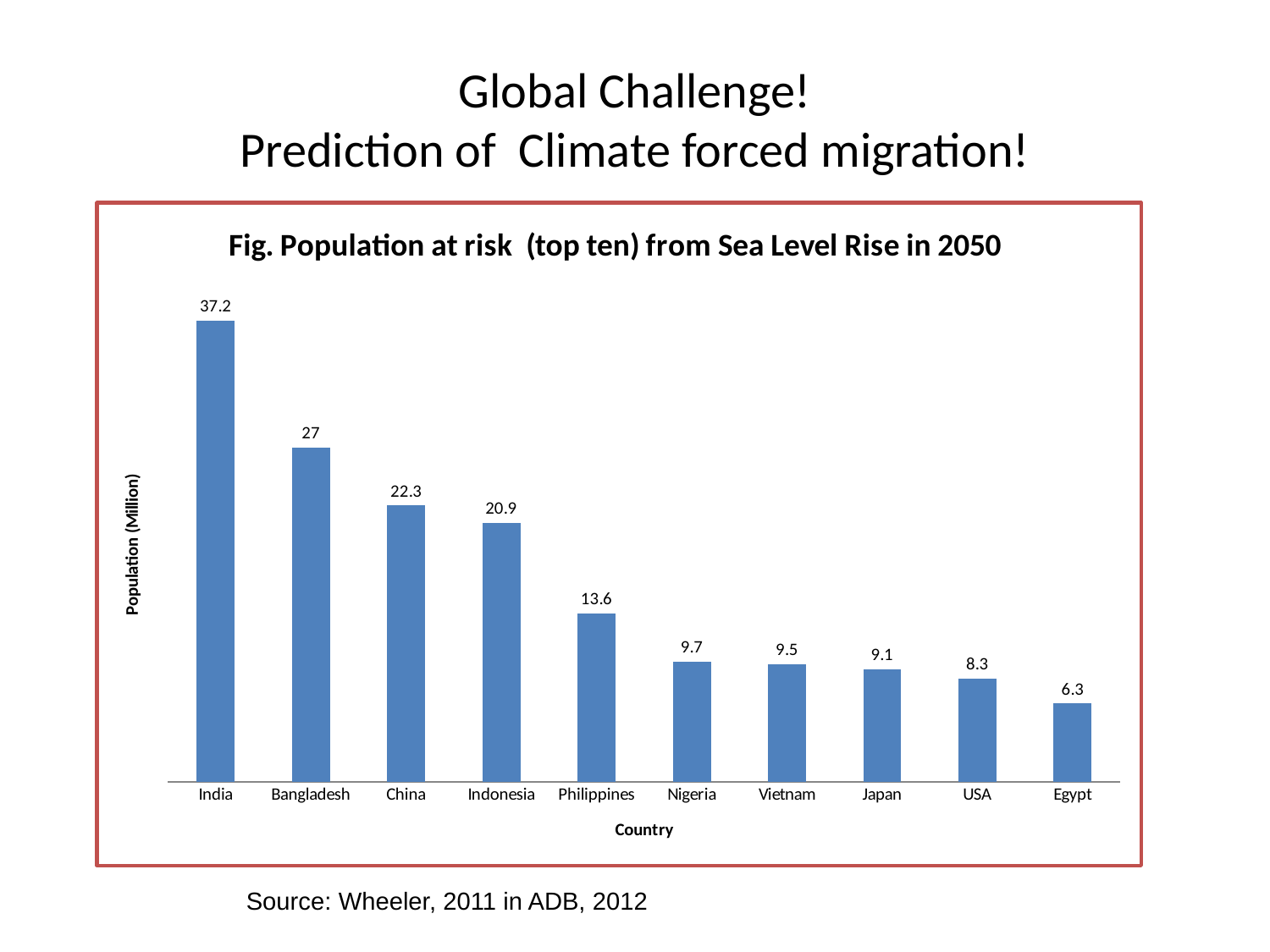
What is the population at risk for India? 37.2 What is the population at risk for Philippines? 13.6 What is the difference between the values for China and Indonesia? 1.4 Which country has the lowest population at risk? Egypt What is the difference between the values for India and Bangladesh? 10.2 What is the population at risk for USA? 8.3 What type of chart is shown? Bar chart How many countries are shown in the chart? 10 What is the label of the vertical axis? Population (Million) Which has a larger population at risk, Nigeria or Japan? Nigeria Which country has the highest population at risk? India What is the population at risk for Bangladesh? 27